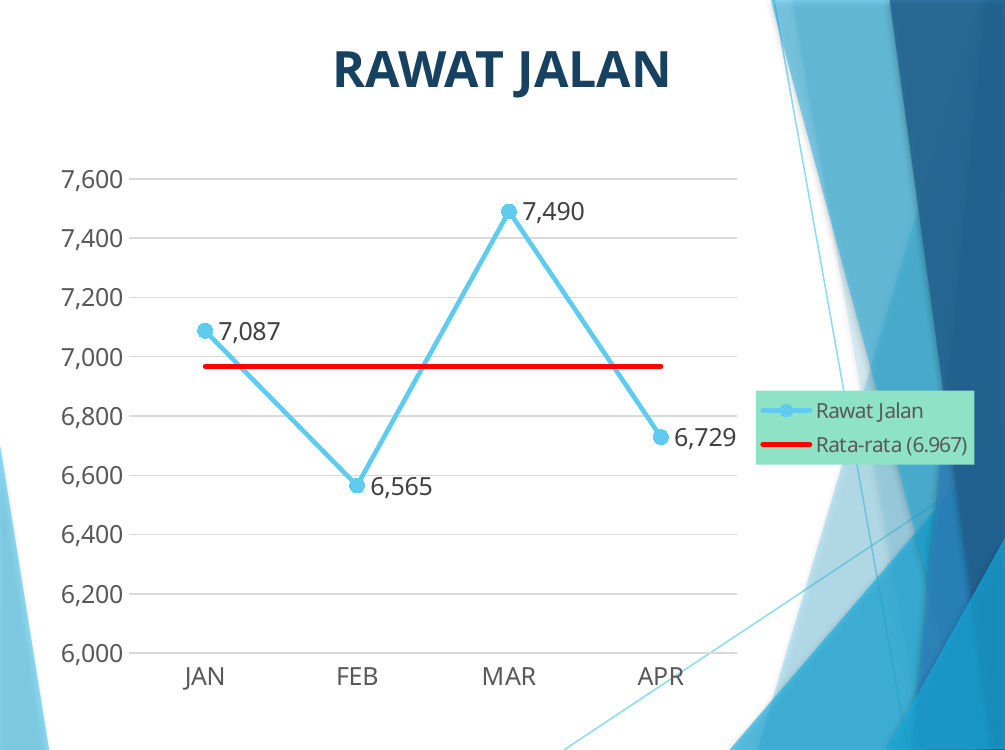
How many series does the legend list? 2 What is the difference between the Rawat Jalan values for MAR and FEB? 925 What is the Rawat Jalan value for JAN? 7,087 Is the Rawat Jalan value for FEB greater or less than 6,600? less Which is larger, the Rawat Jalan value for JAN or for APR? JAN What is the Rawat Jalan value for MAR? 7,490 Which month has the lowest Rawat Jalan value? FEB What kind of chart is shown on the slide? line chart How many months are shown on the x axis? 4 What is the Rawat Jalan value for APR? 6,729 What is the Rawat Jalan value for FEB? 6,565 Which month has the highest Rawat Jalan value? MAR